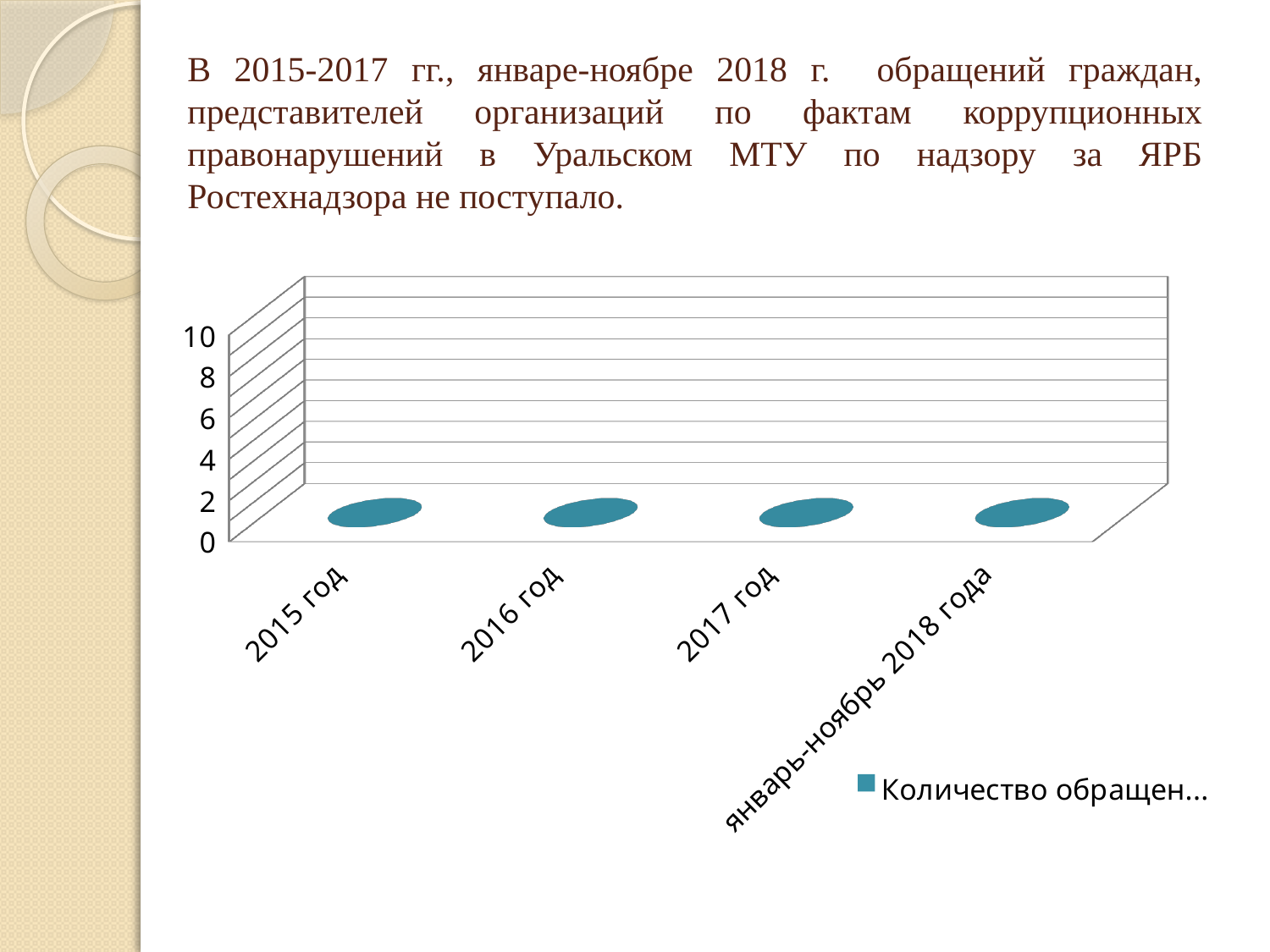
What is the value for 2017 год in the chart? 0 What kind of chart is shown on the slide? bar chart What is the label of the last category on the x axis? январь-ноябрь 2018 года What is the value for 2015 год in the chart? 0 How many series does the chart legend list? 1 What is the highest value shown on the vertical axis of the chart? 10 What is the value for январь-ноябрь 2018 года in the chart? 0 What is the value for 2016 год in the chart? 0 Is the value for январь-ноябрь 2018 года greater or less than 4? less Do the values rise, fall, or stay the same from 2015 год to январь-ноябрь 2018 года? stay the same Is the value for 2017 год greater or less than 2? less How many categories are shown on the x axis of the chart? 4